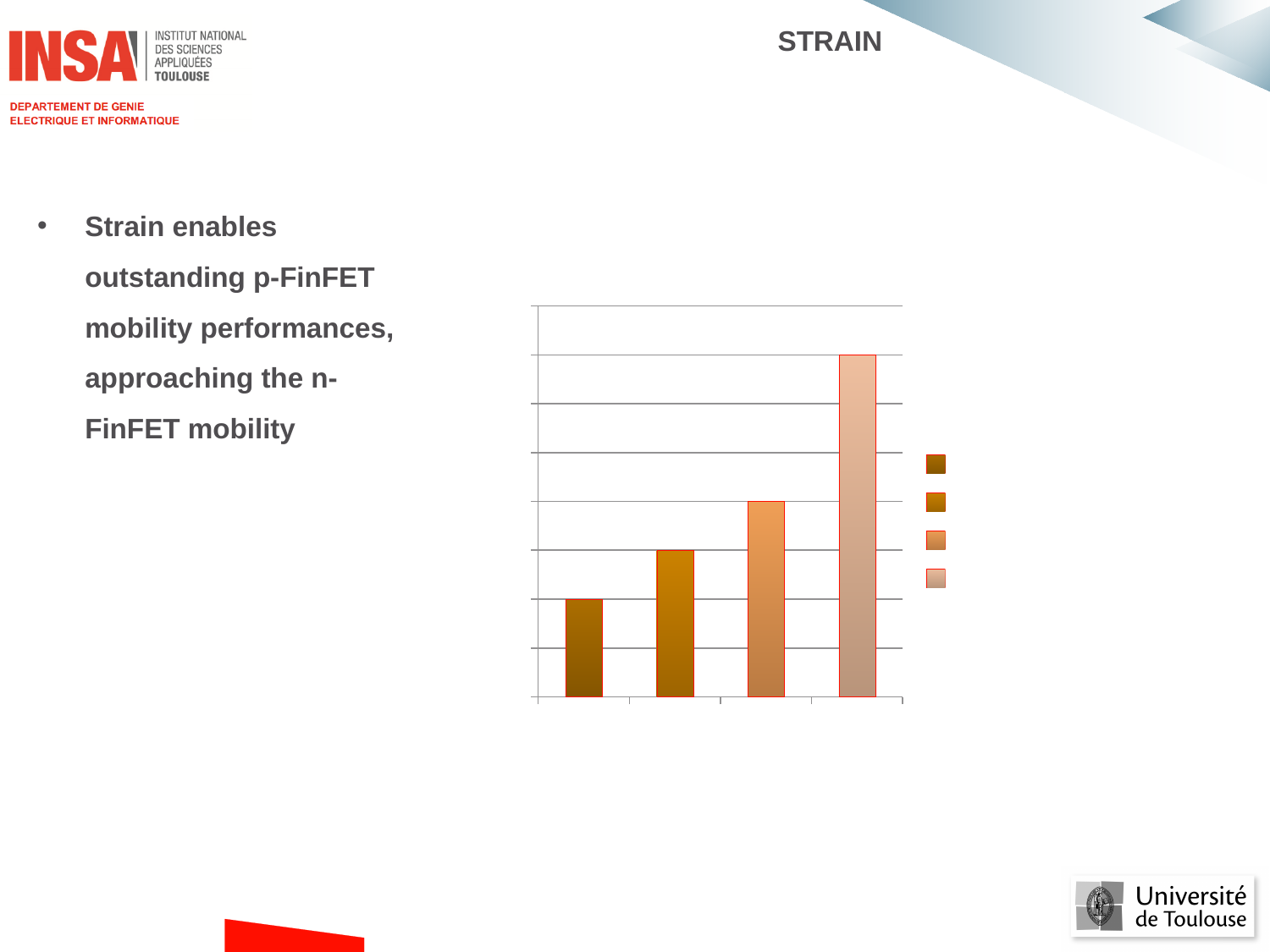
Are the bars in the chart vertical or horizontal? vertical Which is taller, the second bar from the left or the third bar from the left? the third bar How many bars are plotted in the chart? 4 Which is taller, the first bar or the fourth bar? the fourth bar Which bar is the shortest in the chart? the leftmost (first) bar Do the bar heights rise or fall from left to right across the chart? rise What kind of chart is shown on the slide? bar chart Does the chart display any data labels on its bars? No Which bar is the tallest in the chart? the rightmost (fourth) bar How many entries does the chart's legend show? 4